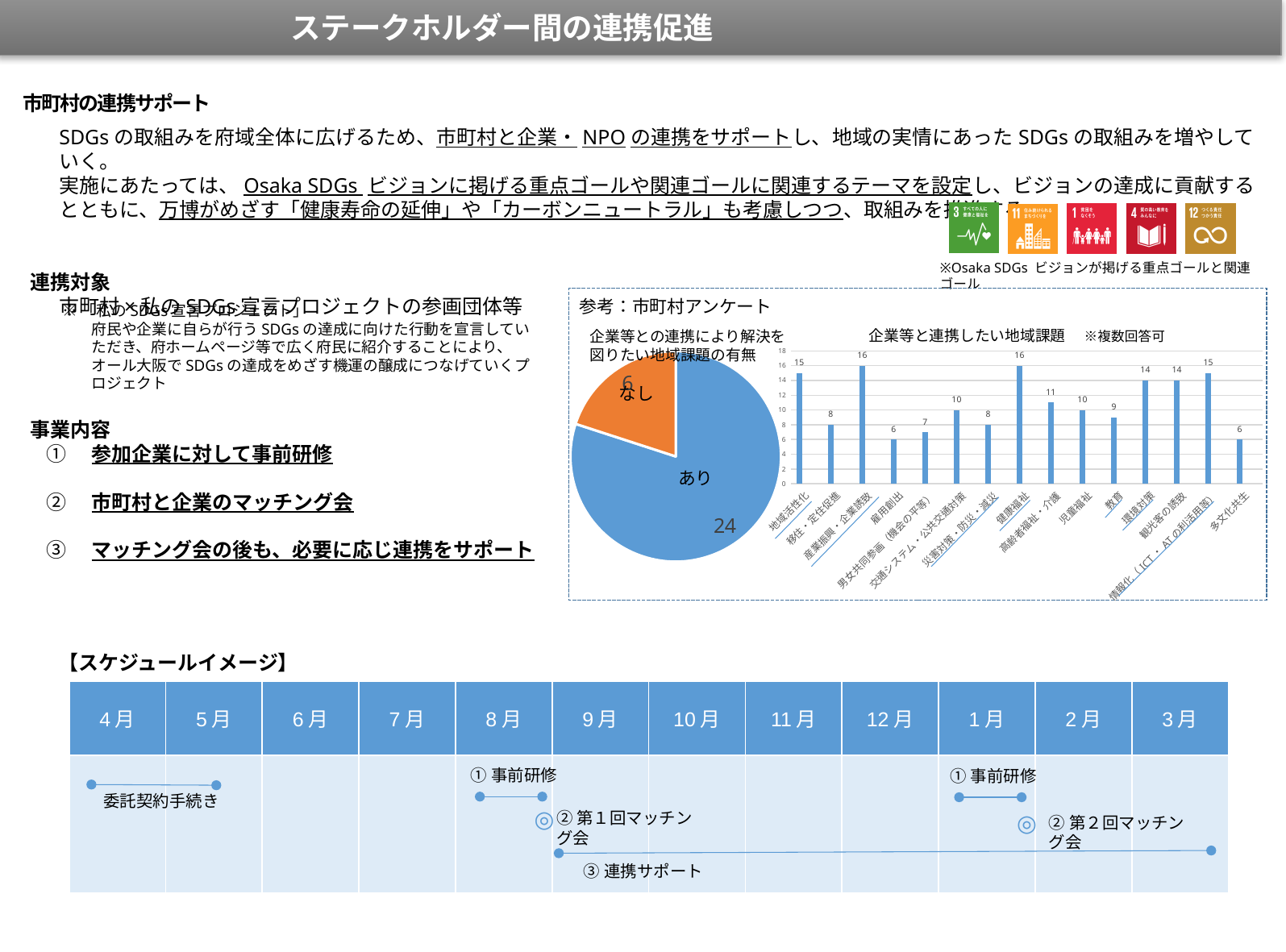
In the bar chart titled 企業等と連携したい地域課題, what is the value for 男女共同参画（機会の平等）? 7 In the pie chart titled 企業等との連携により解決を図りたい地域課題の有無, what is the value for あり? 24 In the pie chart titled 企業等との連携により解決を図りたい地域課題の有無, what is the value for なし? 6 In the pie chart titled 企業等との連携により解決を図りたい地域課題の有無, what share of the total does あり represent? 80% In the bar chart titled 企業等と連携したい地域課題, which category has the lowest value? 雇用創出 and 多文化共生 (both 6) In the pie chart titled 企業等との連携により解決を図りたい地域課題の有無, how many slices are there? 2 In the bar chart titled 企業等と連携したい地域課題, which is larger, 環境対策 or 教育? 環境対策 What kind of chart is the one titled 企業等と連携したい地域課題? Bar chart In the bar chart titled 企業等と連携したい地域課題, what is the value for 高齢者福祉・介護? 11 In the bar chart titled 企業等と連携したい地域課題, what is the difference between 健康福祉 and 児童福祉? 6 In the bar chart titled 企業等と連携したい地域課題, how many categories are shown? 15 In the bar chart titled 企業等と連携したい地域課題, what is the value for 地域活性化? 15